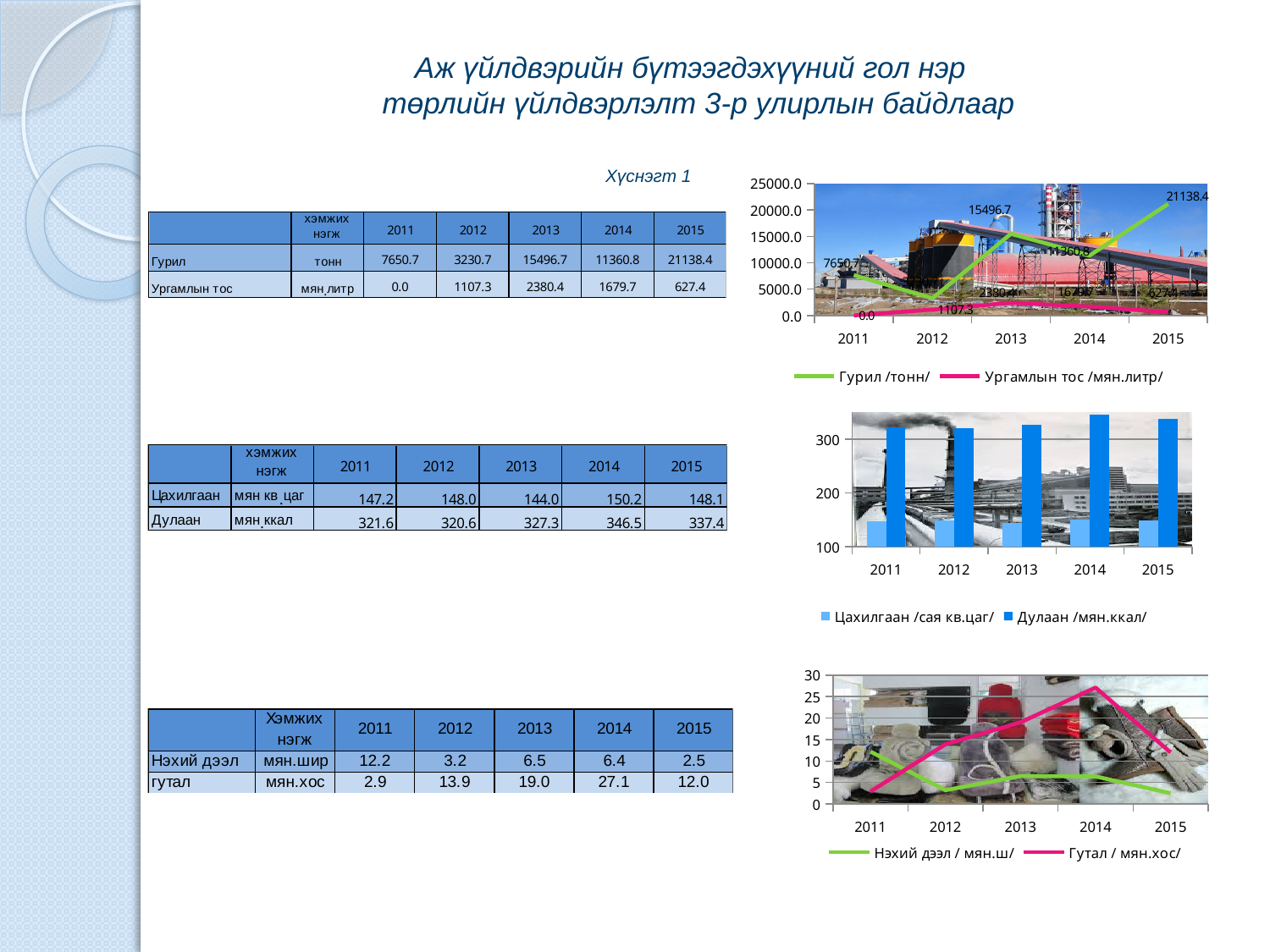
How many series does the legend of the top chart on the right list? 2 In the top chart on the right, what is the value for Ургамлын тос /мян.литр/ in 2012? 1107.3 What kind of chart is the top chart on the right (Гурил / Ургамлын тос)? line chart In the middle chart on the right, is the value for Дулаан /мян.ккал/ in 2014 greater or less than 300? greater In the top chart on the right, what is the value for Гурил /тонн/ in 2015? 21138.4 In the bottom chart on the right, which series has the higher value in 2011, Нэхий дээл or Гутал? Нэхий дээл In the top chart on the right, which year has the highest value for Гурил /тонн/? 2015 In the top chart on the right, what is the value for Гурил /тонн/ in 2013? 15496.7 In the middle chart on the right, is the value for Цахилгаан /сая кв.цаг/ in 2011 greater or less than 200? less In the top chart on the right, what is the difference between the Гурил /тонн/ values for 2015 and 2013? 5641.7 How many years are shown on the x axis of the middle chart on the right? 5 What kind of chart is the middle chart on the right (Цахилгаан / Дулаан)? bar chart